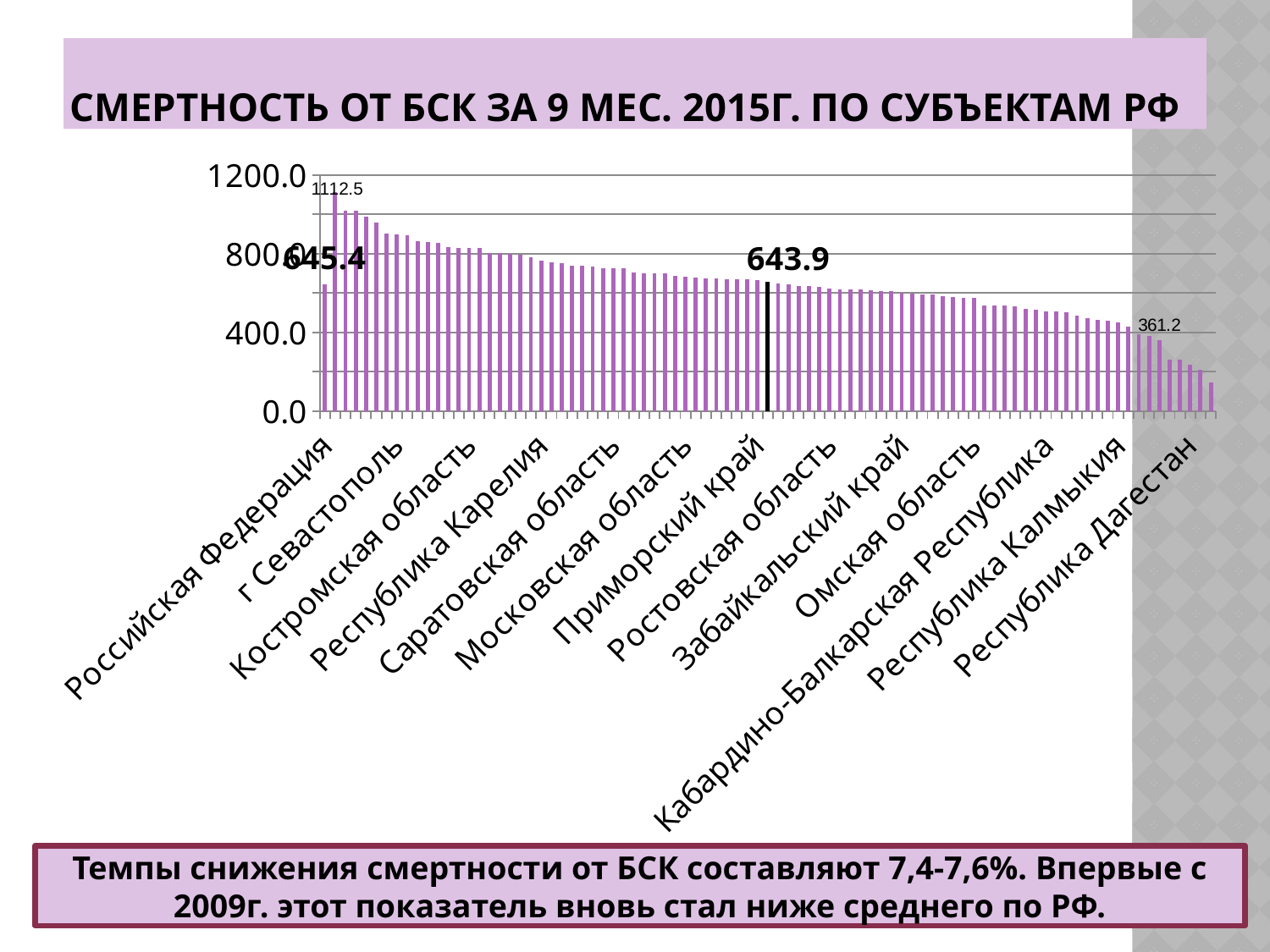
Do the values rise or fall from left to right after the first bar? Fall Is the value for г Севастополь greater or less than 800? greater What is the value for Российская Федерация? 645.4 What is the value of the tallest bar in the chart? 1112.5 Is the value for Омская область greater or less than 800? less Is the value for Республика Дагестан greater or less than 400? less What kind of chart is shown on the slide? Bar chart Which labelled category has the lowest value? Республика Дагестан